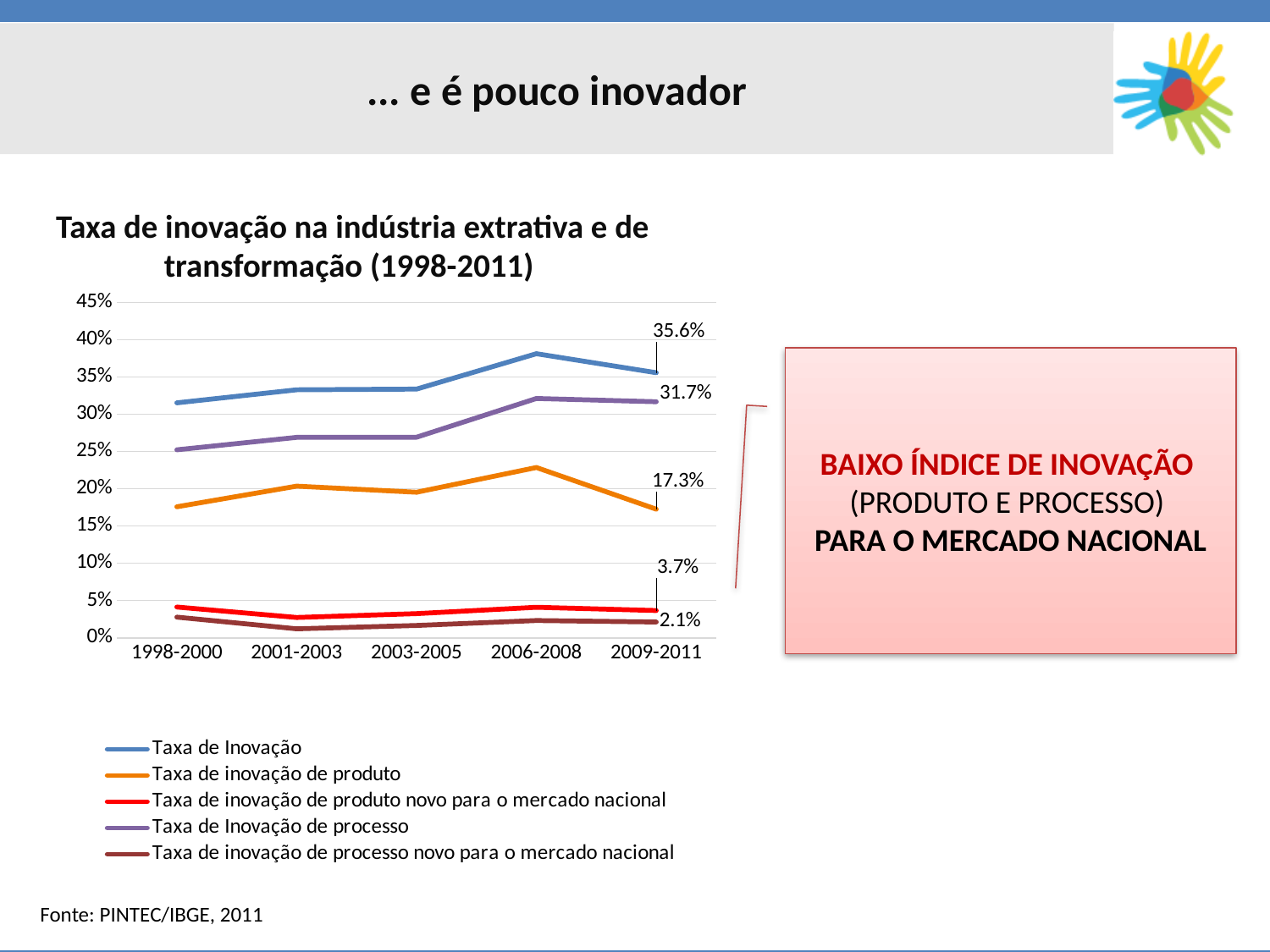
How many series does the legend list? 5 What kind of chart is shown on the slide? Line chart How many time periods are shown on the x axis? 5 In 2009-2011, which is larger: Taxa de inovação de produto or Taxa de inovação de produto novo para o mercado nacional? Taxa de inovação de produto Which series has the lowest value in 2009-2011? Taxa de inovação de processo novo para o mercado nacional What is the value of Taxa de Inovação for 2009-2011? 35.6% What is the difference between Taxa de Inovação and Taxa de Inovação de processo in 2009-2011? 3.9 percentage points What is the value of Taxa de Inovação de processo for 2009-2011? 31.7% Is the value of Taxa de inovação de produto for 1998-2000 greater or less than 20%? less What is the value of Taxa de inovação de processo novo para o mercado nacional for 2009-2011? 2.1% What is the value of Taxa de inovação de produto for 2009-2011? 17.3% Is the value of Taxa de Inovação for 2006-2008 greater or less than 35%? greater